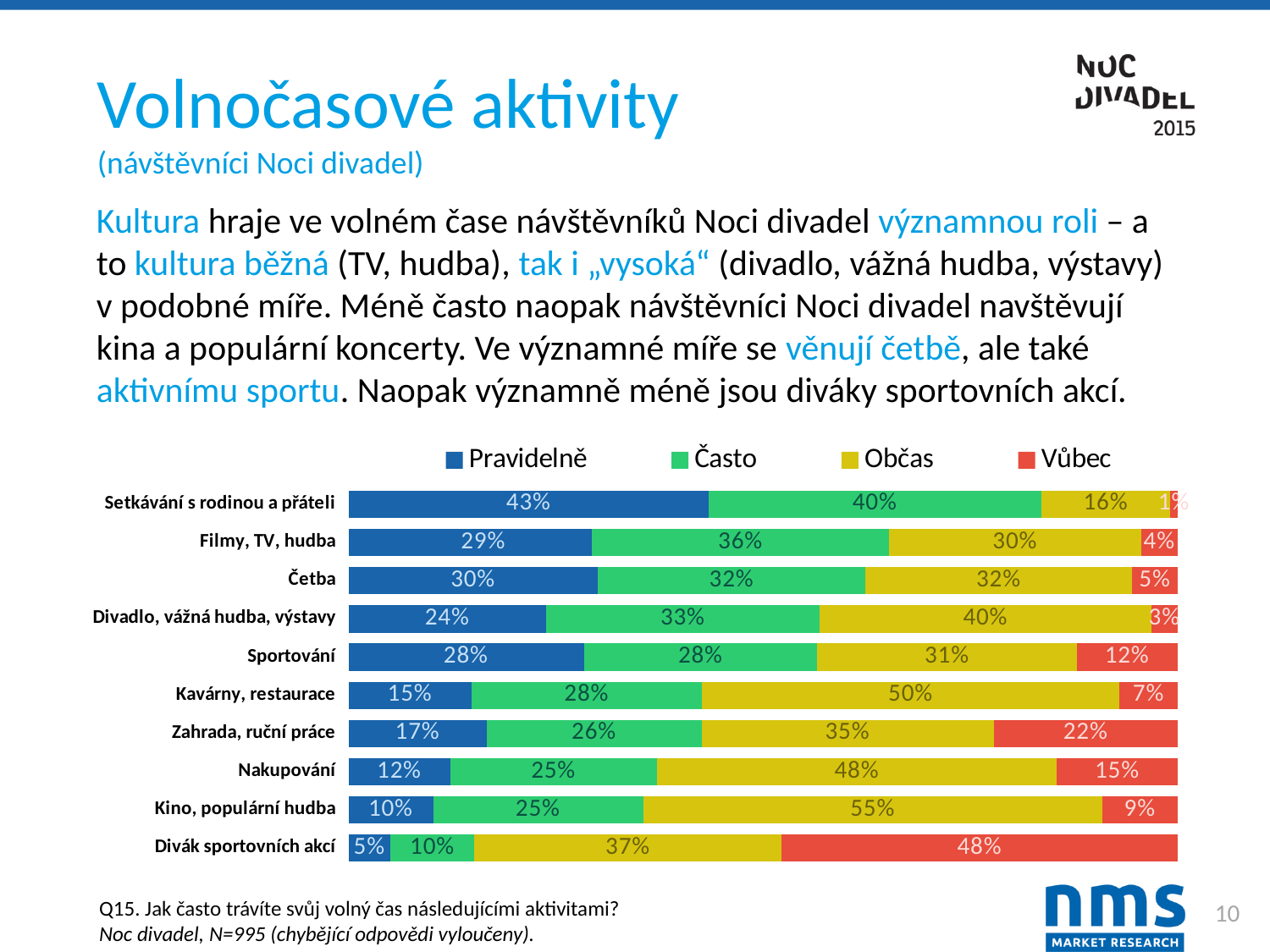
Which legend entry is shown in red? Vůbec Which is larger: the 'Často' value for 'Filmy, TV, hudba' or the 'Často' value for 'Četba'? Filmy, TV, hudba What is the total of the stacked bar for 'Zahrada, ruční práce'? 100% Which category has the highest 'Pravidelně' value? Setkávání s rodinou a přáteli What is the difference between the 'Vůbec' values for 'Zahrada, ruční práce' and 'Nakupování'? 7% What is the 'Vůbec' value for 'Divák sportovních akcí'? 48% What is the 'Pravidelně' value for 'Setkávání s rodinou a přáteli'? 43% Which category has the lowest 'Pravidelně' value? Divák sportovních akcí What is the 'Občas' value for 'Kino, populární hudba'? 55% What type of chart is shown on the slide? stacked bar chart How many series does the legend list? 4 How many activity categories are shown in the chart? 10